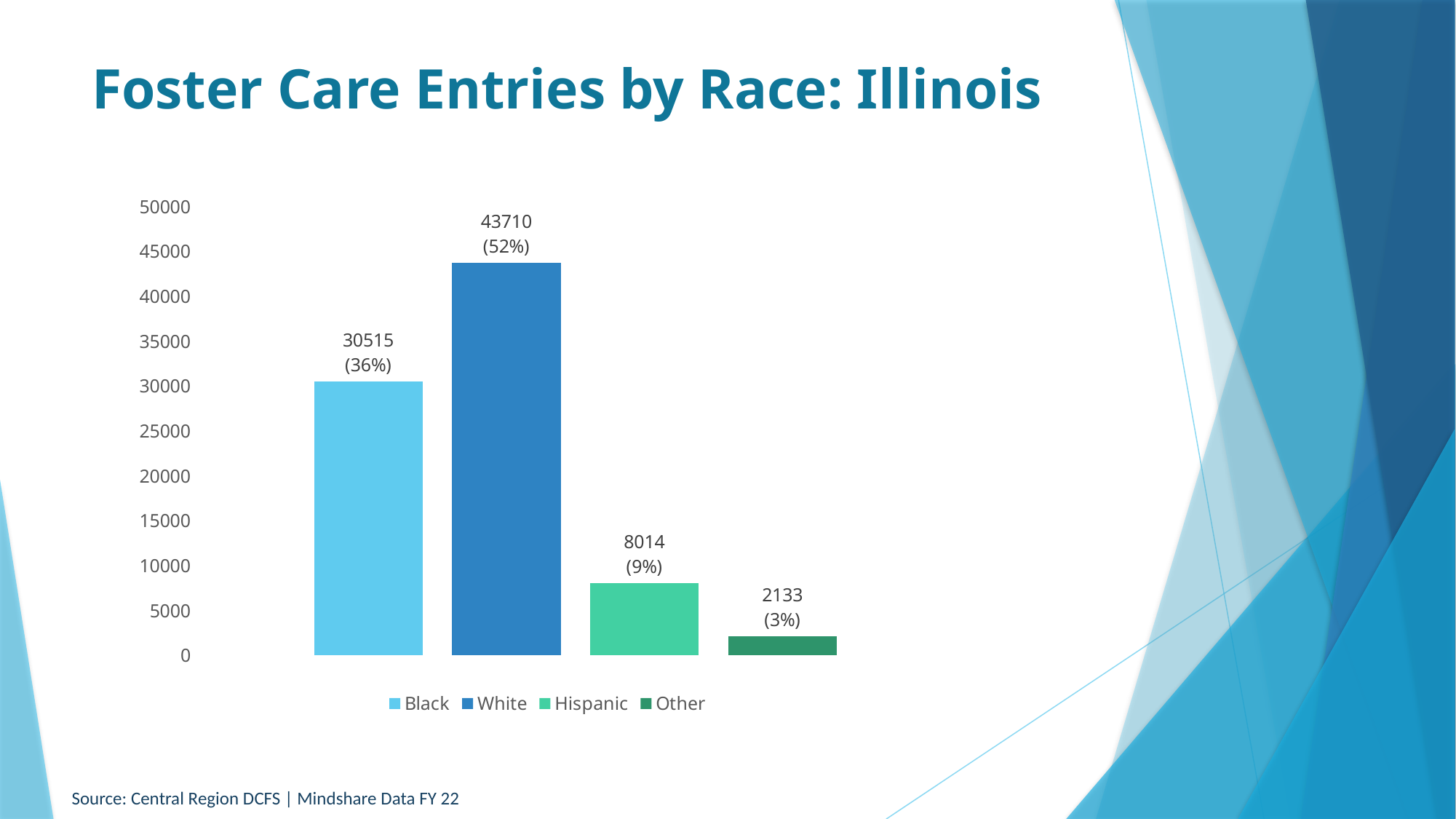
What is the number of foster care entries for Hispanic? 8014 Is the value for Black greater or less than 25000? greater What is the title of the slide? Foster Care Entries by Race: Illinois Which race category has the lowest number of foster care entries? Other What kind of chart is shown on the slide? Bar chart What is the difference between the White and Black foster care entries? 13195 What percentage of foster care entries is labelled for Other? 3% What is the number of foster care entries for White? 43710 Which race category has the highest number of foster care entries? White Which has more foster care entries, Hispanic or Other? Hispanic What is the number of foster care entries for Black? 30515 How many race categories are shown in the chart? 4